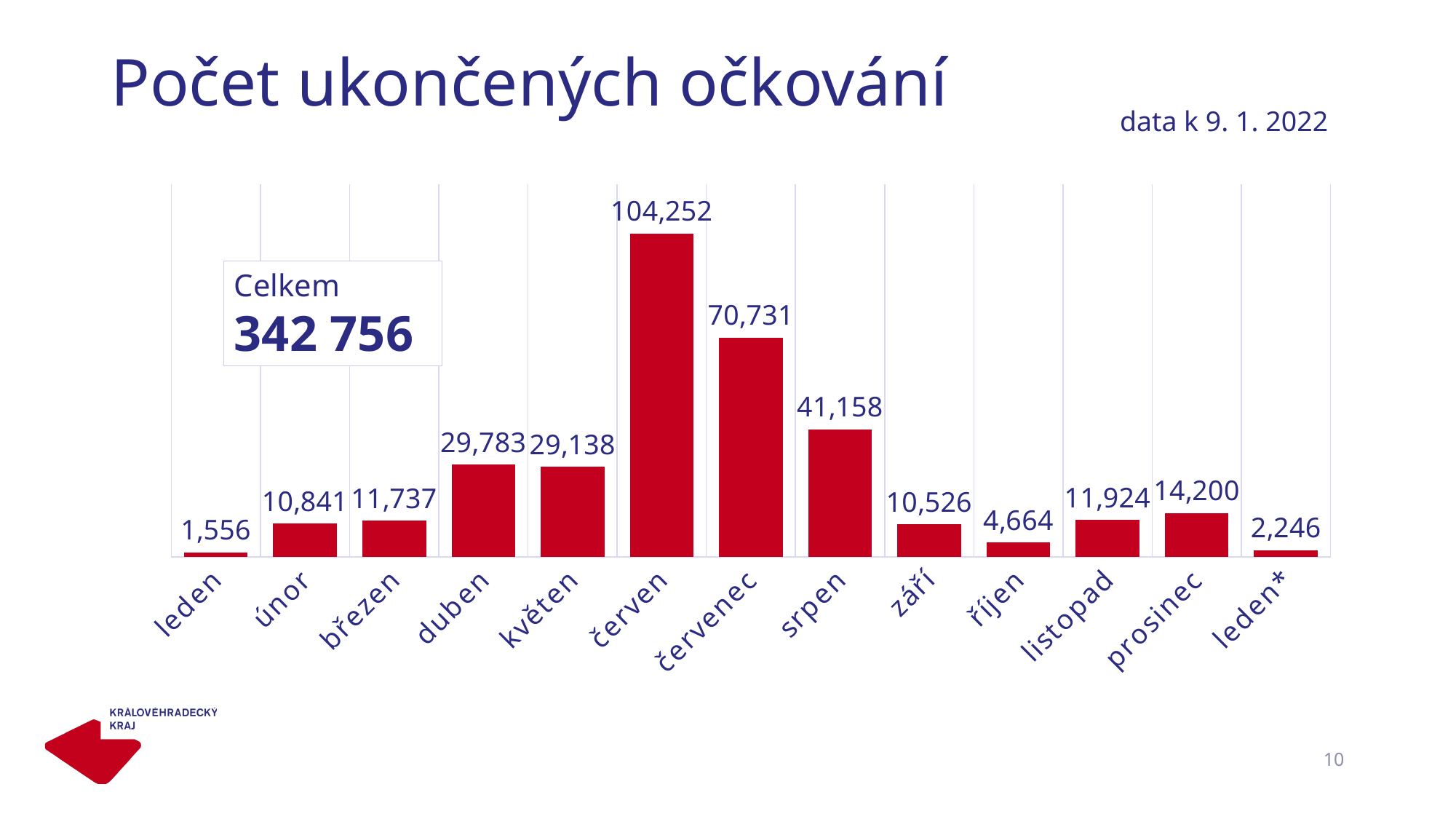
What kind of chart is shown on the slide? bar chart What is the value for leden*? 2,246 How many categories are shown on the x axis? 13 What is the value for srpen? 41,158 Which is larger, the value for září or the value for říjen? září What total (Celkem) is shown in the box on the chart? 342 756 What is the value for červen? 104,252 Which is larger, the value for duben or the value for květen? duben What is the difference between the values for prosinec and listopad? 2,276 Which month has the lowest value? leden Which month has the highest value? červen What is the difference between the values for červen and červenec? 33,521